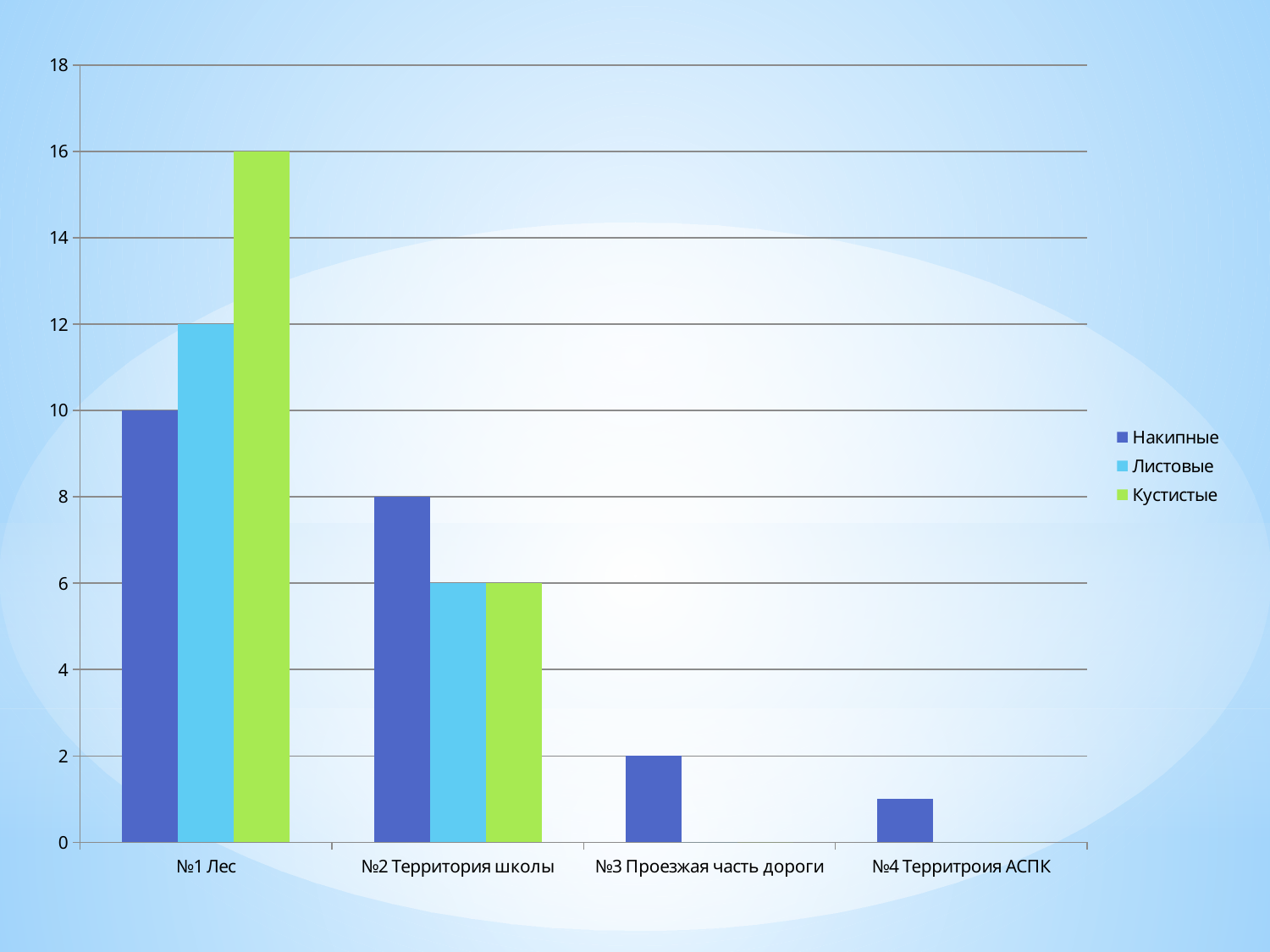
What is the difference between Кустистые and Накипные in №1 Лес? 6 How many categories are shown on the x axis? 4 Which is larger in №2 Территория школы: Накипные or Листовые? Накипные What is the value for Листовые in №1 Лес? 12 What is the value for Кустистые in №1 Лес? 16 Which category has the lowest value for Накипные? №4 Территроия АСПК Is the value for Накипные in №4 Территроия АСПК greater or less than 2? less What kind of chart is shown on the slide? bar chart Which category has the highest value for Накипные? №1 Лес What is the value for Накипные in №2 Территория школы? 8 How many series does the legend list? 3 What is the value for Накипные in №3 Проезжая часть дороги? 2